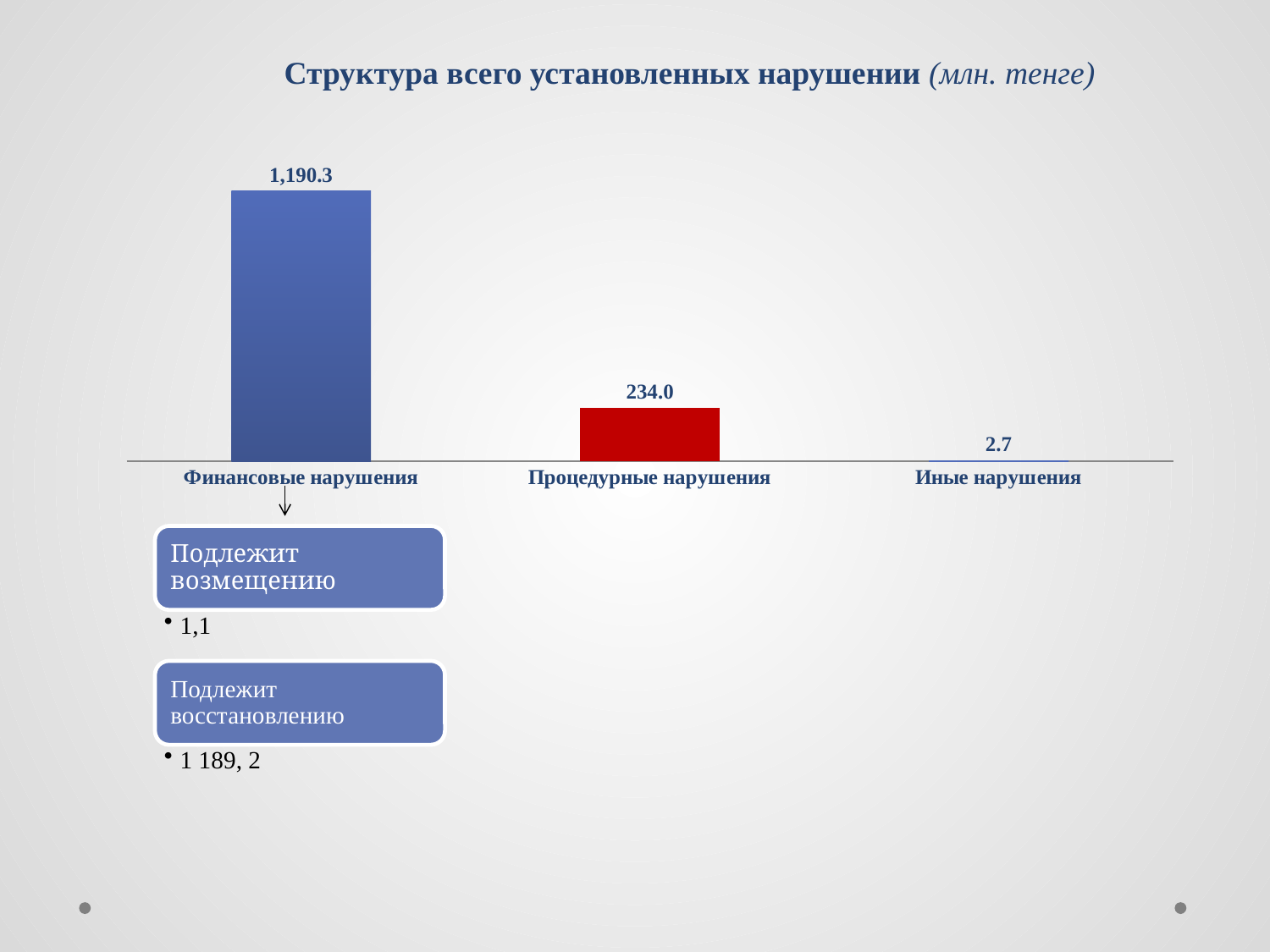
Which category has the highest value? Финансовые нарушения Do the values rise or fall from left to right across the categories? fall What is the value for Процедурные нарушения? 234.0 What kind of chart is shown on the slide? bar chart What is the difference between the values for Процедурные нарушения and Иные нарушения? 231.3 Which is larger, the value for Процедурные нарушения or the value for Иные нарушения? Процедурные нарушения Which category has the lowest value? Иные нарушения How many categories are shown in the chart? 3 What is the value for Финансовые нарушения? 1,190.3 What is the value for Иные нарушения? 2.7 What is the difference between the values for Финансовые нарушения and Процедурные нарушения? 956.3 What is the title of the chart? Структура всего установленных нарушении (млн. тенге)